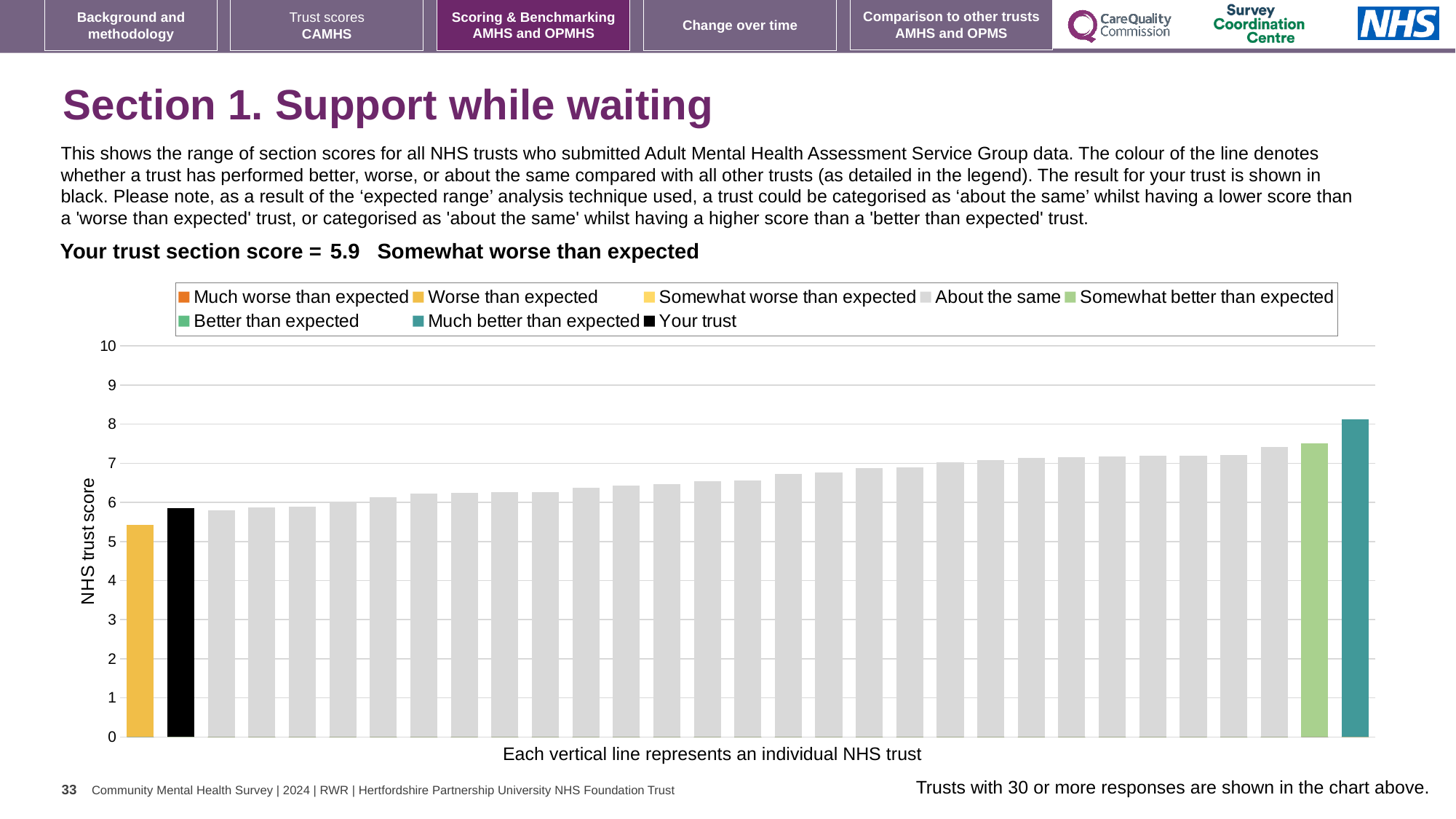
Which legend category does the shortest bar in the chart belong to? Worse than expected Which legend category does the tallest bar in the chart belong to? Much better than expected Do the bar values rise or fall from left to right across the chart? rise What kind of chart is shown on the slide? bar chart Is the value of the tallest bar greater or less than 7? greater Which category does your trust's section score fall into? Somewhat worse than expected What colour is the bar representing your trust? black What is the section score for your trust shown on the slide? 5.9 What is the label on the vertical axis of the chart? NHS trust score Is the value of the shortest bar greater or less than 6? less Which is larger: the bar for your trust or the 'Worse than expected' bar to its left? the bar for your trust How many entries does the chart legend list? 8